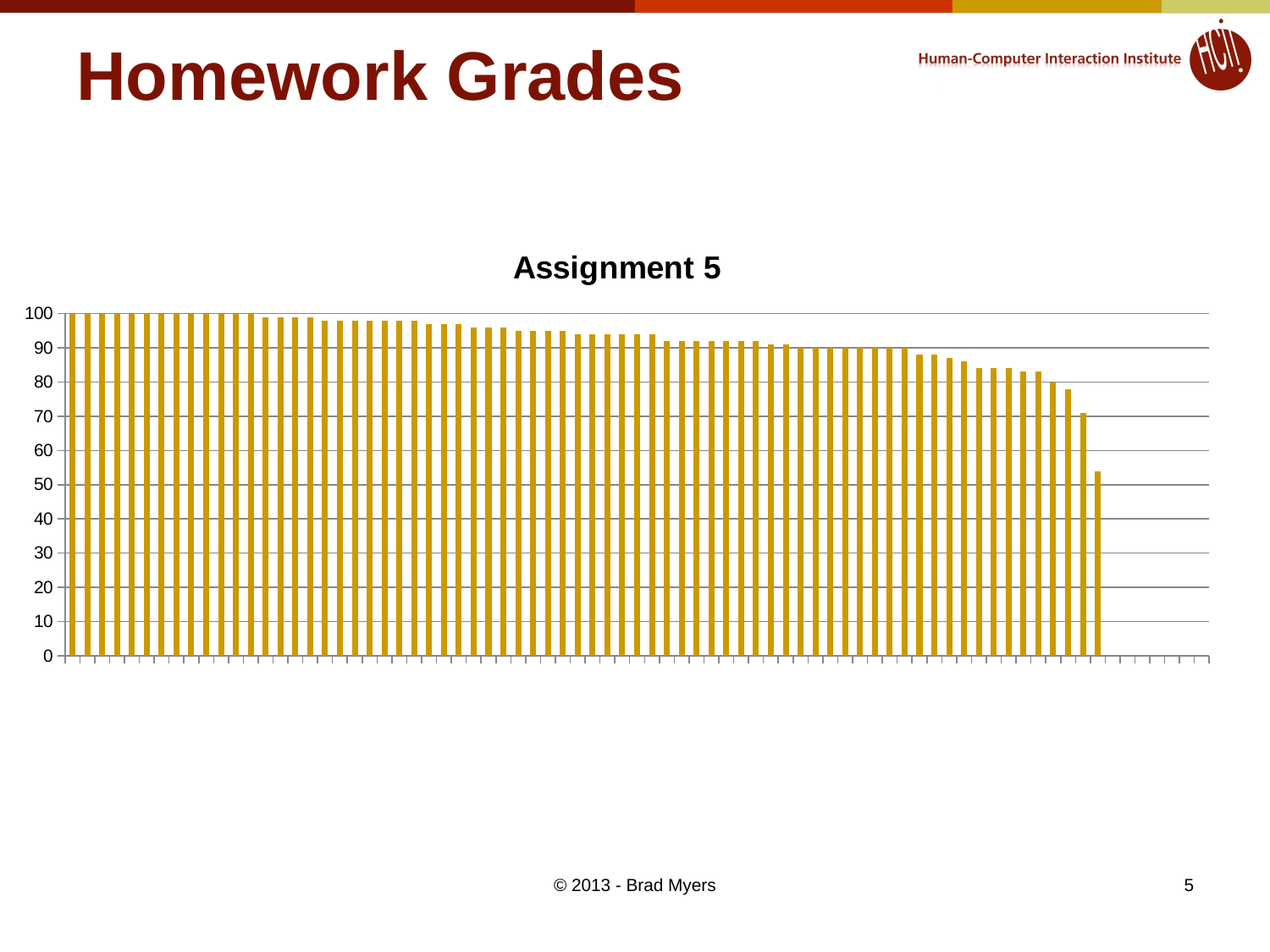
Is the value of the second bar from the right greater or less than 80? less What kind of chart is shown on the slide? bar chart Do the bar values rise or fall moving from left to right along the x axis? fall Is the value of the rightmost bar greater or less than 60? less Is the value of the bar in the middle of the chart greater or less than 80? greater What is the title of the chart? Assignment 5 What is the highest value shown on the vertical axis? 100 Which bar has the lowest value, the leftmost or the rightmost? rightmost Which is larger, the value of the leftmost bar or the value of the rightmost bar? leftmost bar